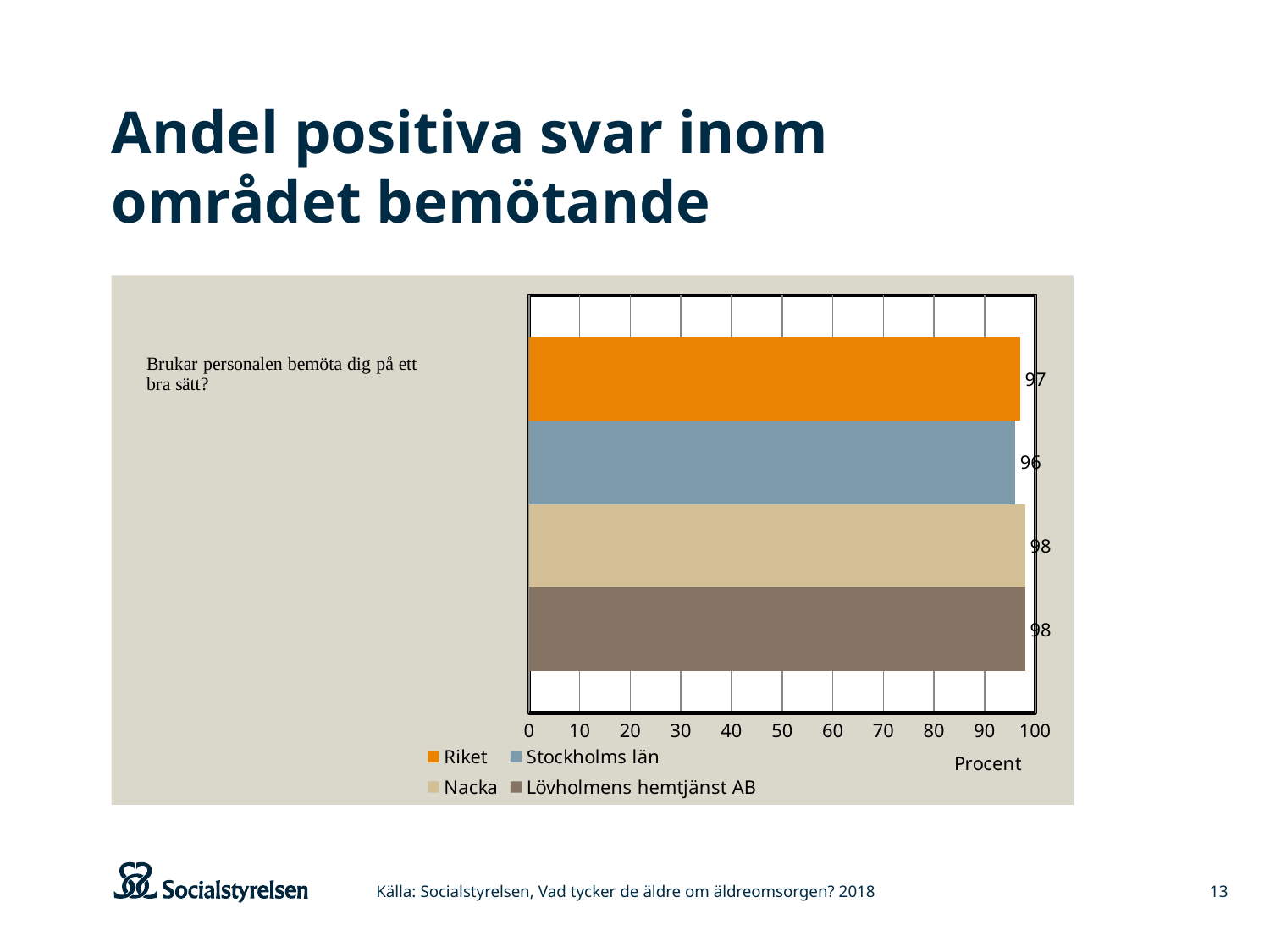
Is the value for Stockholms län greater or less than 90? greater What is the label of the horizontal axis? Procent How many series does the legend list? 4 Which series has the lowest value? Stockholms län What value is shown for Lövholmens hemtjänst AB? 98 What kind of chart is shown on the slide? Bar chart What is the difference between the values for Nacka and Stockholms län? 2 What is the difference between the values for Riket and Stockholms län? 1 What value is shown for Stockholms län? 96 Which is larger, the value for Riket or the value for Stockholms län? Riket What value is shown for Nacka? 98 What value is shown for Riket? 97